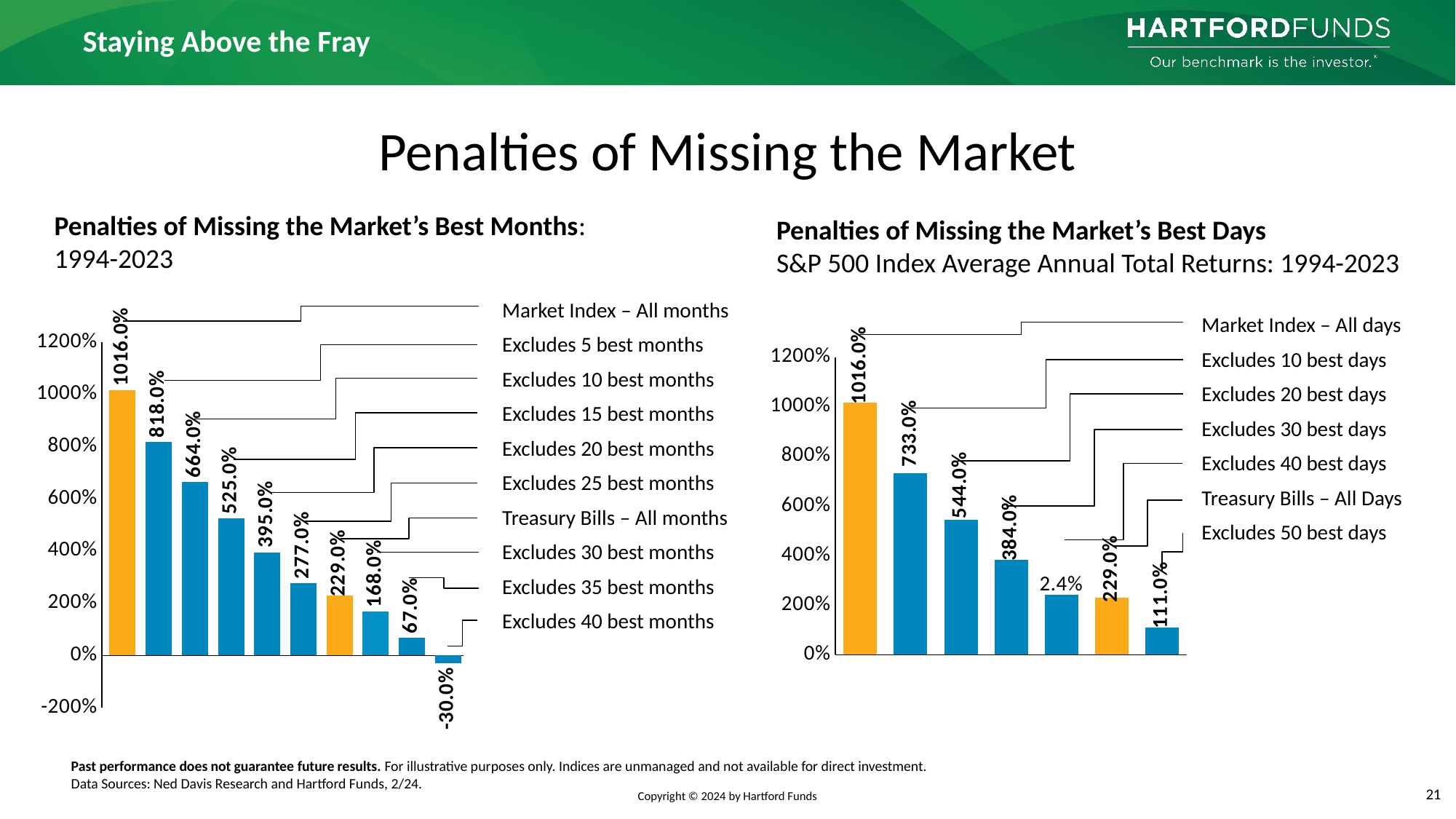
How many bars are in the Penalties of Missing the Market's Best Days chart? 7 In the Penalties of Missing the Market's Best Days chart, what is the value for Excludes 20 best days? 544.0% In the Penalties of Missing the Market's Best Days chart, what is the value for Treasury Bills – All Days? 229.0% In the Penalties of Missing the Market's Best Months chart, what is the difference between Market Index – All months and Excludes 10 best months? 352.0% In the Penalties of Missing the Market's Best Months chart, which category has the lowest value? Excludes 40 best months In the Penalties of Missing the Market's Best Months chart, do the values generally rise or fall from left to right? Fall How many bars are in the Penalties of Missing the Market's Best Months chart? 10 In the Penalties of Missing the Market's Best Months chart, what is the value for Excludes 40 best months? -30.0% In the Penalties of Missing the Market's Best Days chart, which is larger: Excludes 10 best days or Excludes 30 best days? Excludes 10 best days In the Penalties of Missing the Market's Best Months chart, what is the value for Excludes 5 best months? 818.0% In the Penalties of Missing the Market's Best Days chart, which category has the highest value? Market Index – All days What kind of chart is the Penalties of Missing the Market's Best Days chart? Bar chart